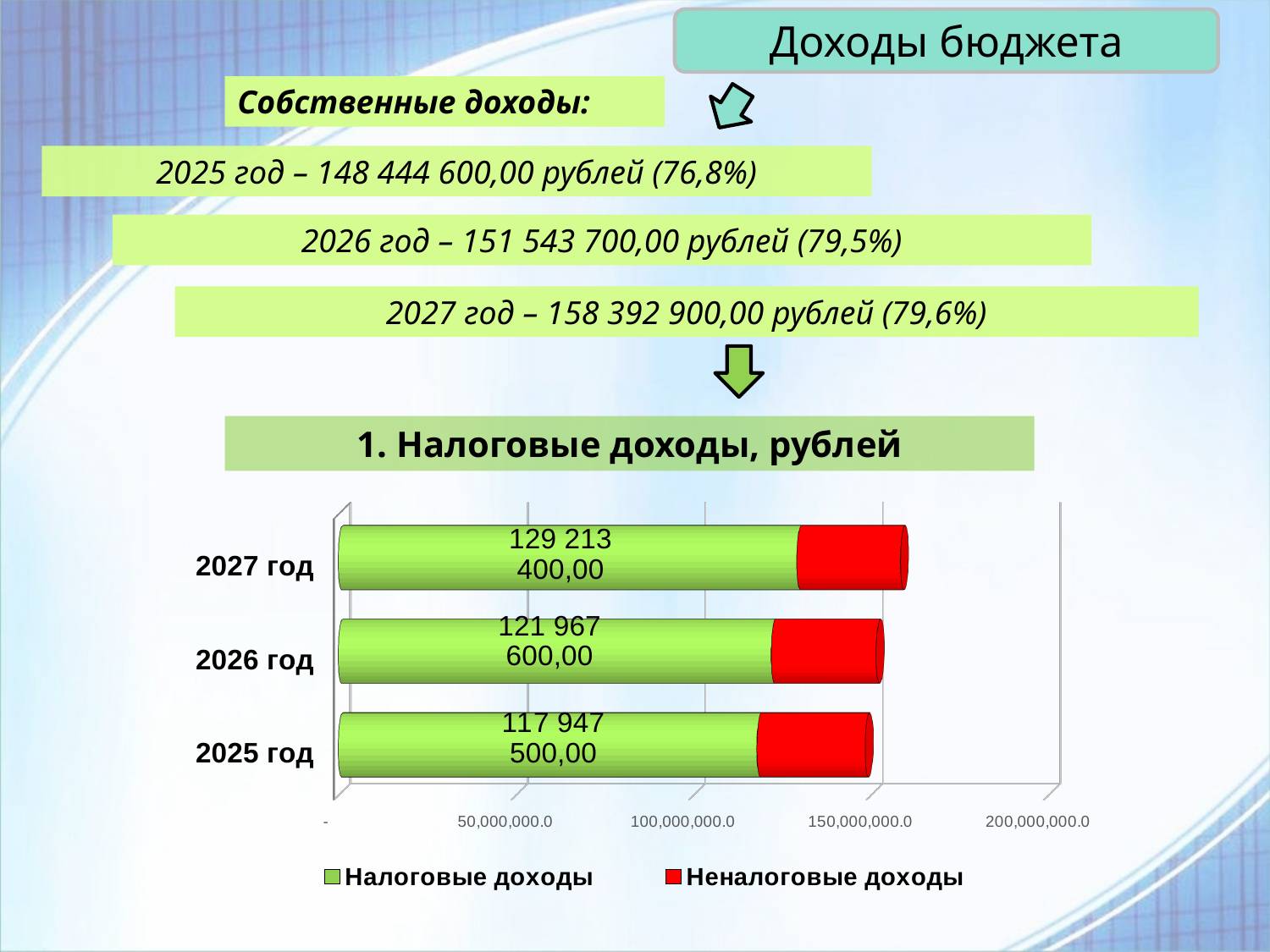
How many series does the legend list? 2 Which year has the lowest value of Налоговые доходы? 2025 год Which year has the highest value of Налоговые доходы? 2027 год What is the value of Налоговые доходы for 2025 год? 117 947 500,00 What is the value of Налоговые доходы for 2026 год? 121 967 600,00 Which is larger: Налоговые доходы for 2026 год or for 2025 год? 2026 год Which colour represents Неналоговые доходы in the chart? red How many years (categories) are shown in the chart? 3 Is the value of Налоговые доходы for 2027 год greater or less than 100,000,000.0? greater What kind of chart is shown on the slide? bar chart What is the value of Налоговые доходы for 2027 год? 129 213 400,00 What is the difference between Налоговые доходы for 2027 год and 2025 год? 11 265 900,00